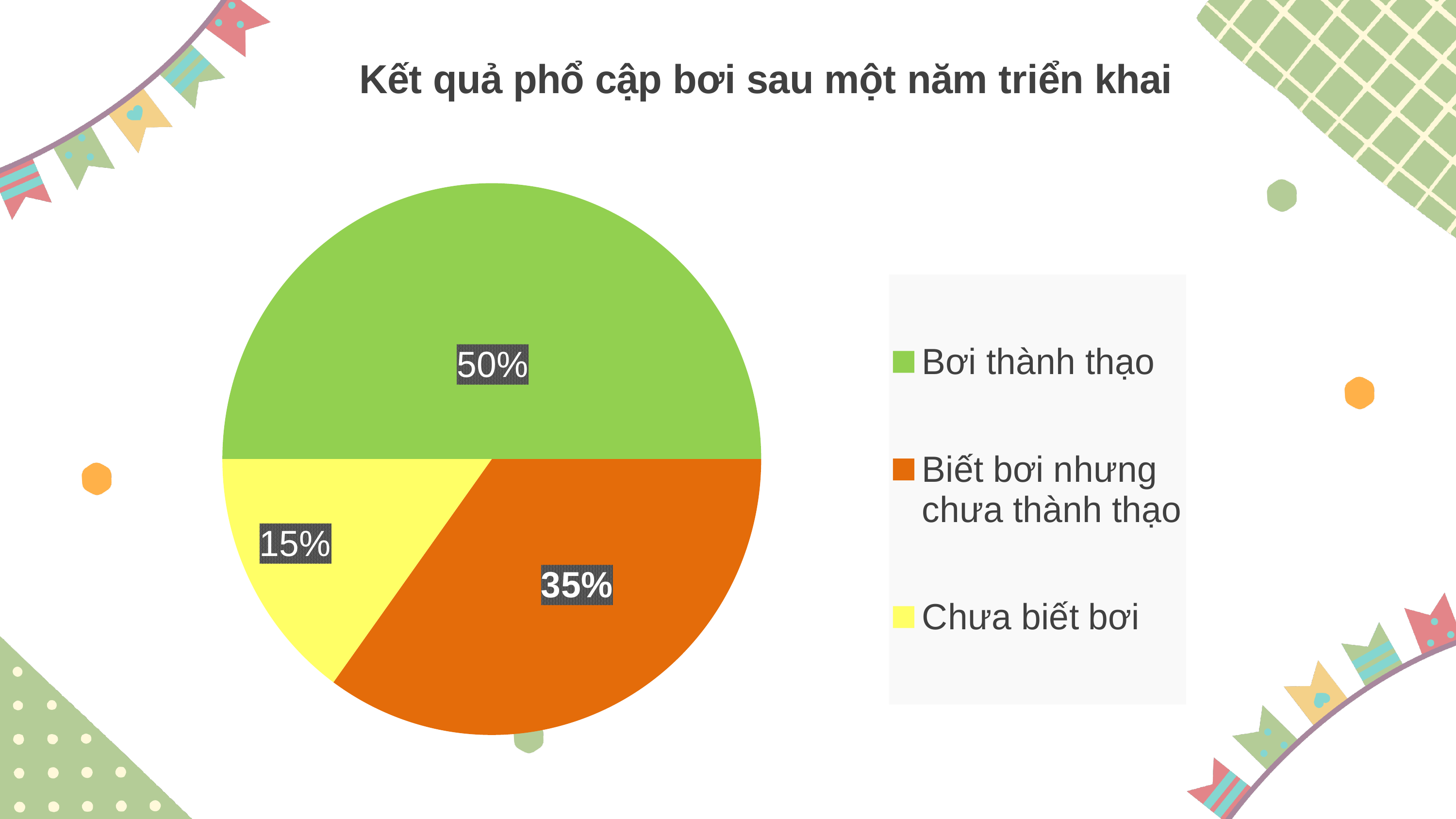
What is the title of the chart? Kết quả phổ cập bơi sau một năm triển khai How many slices does the pie chart have? 3 What kind of chart is shown on the slide? Pie chart Which category has the largest share of the pie? Bơi thành thạo What is the difference between the shares for "Biết bơi nhưng chưa thành thạo" and "Chưa biết bơi"? 20% What is the value for "Chưa biết bơi"? 15% What colour is the slice for "Chưa biết bơi"? Yellow Which category has the smallest share of the pie? Chưa biết bơi Which is larger: the share for "Biết bơi nhưng chưa thành thạo" or the share for "Chưa biết bơi"? Biết bơi nhưng chưa thành thạo What is the value for "Bơi thành thạo"? 50% What is the difference between the shares for "Bơi thành thạo" and "Chưa biết bơi"? 35% What is the value for "Biết bơi nhưng chưa thành thạo"? 35%